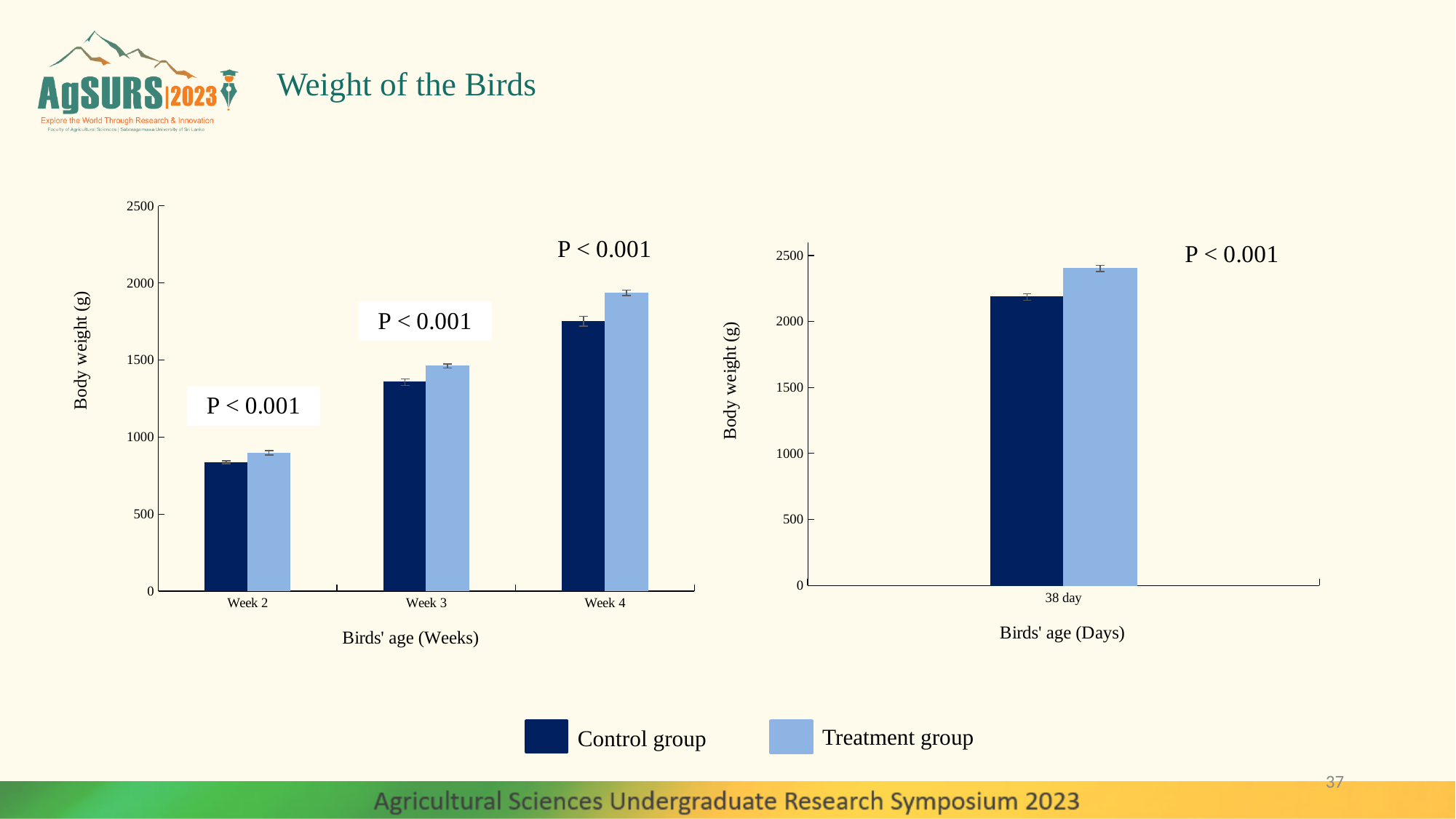
What is the y-axis label of the right chart (Birds' age in Days)? Body weight (g) What kind of chart is the left chart (Birds' age in Weeks)? bar chart How many age categories are shown on the x axis of the left chart (Birds' age in Weeks)? 3 In the left chart (Birds' age in Weeks), is the Control group value for Week 3 greater or less than 1500? less In the left chart (Birds' age in Weeks), which week has the highest Treatment group body weight? Week 4 In the left chart (Birds' age in Weeks), which week has the lowest Control group body weight? Week 2 In the left chart (Birds' age in Weeks), do the Control group values rise or fall from Week 2 to Week 4? rise In the left chart (Birds' age in Weeks), is the Treatment group value for Week 4 greater or less than 1500? greater In the right chart (Birds' age in Days), which group has the larger body weight at 38 day, Control group or Treatment group? Treatment group In the right chart (Birds' age in Days), is the Control group value at 38 day greater or less than 2000? greater How many series does the shared legend list? 2 What colour represents the Treatment group in the legend? light blue